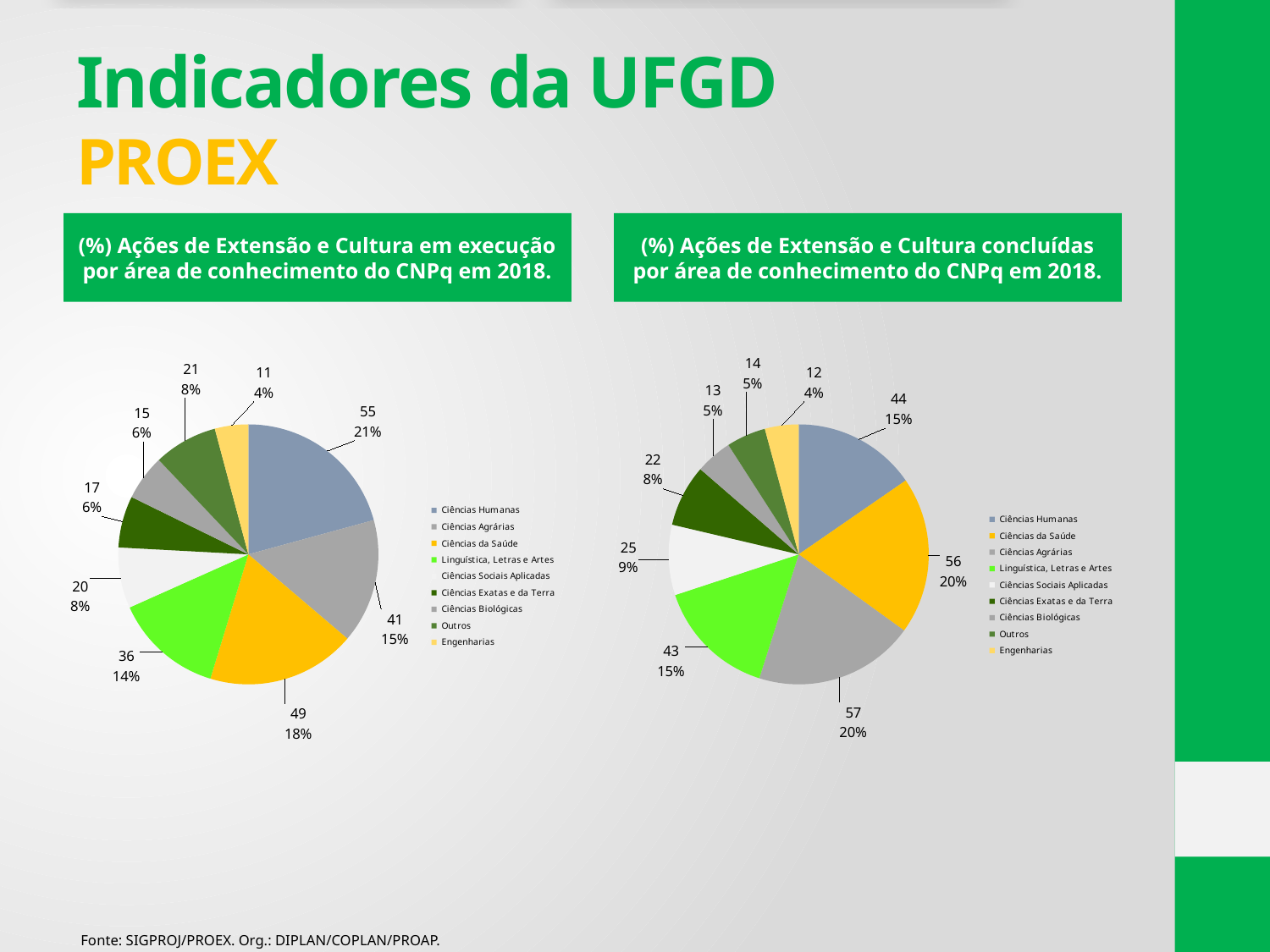
In the left pie chart (ações em execução), which area has the largest slice? Ciências Humanas How many categories does the legend of the left pie chart list? 9 What type of chart is used on the right side of the slide? Pie chart In the left pie chart (ações em execução), which area has the smallest slice? Engenharias In the right pie chart (ações concluídas), which is larger, the value for Ciências Humanas or the value for Ciências Exatas e da Terra? Ciências Humanas In the left pie chart (ações em execução), what value is shown for Ciências Humanas? 55 In the right pie chart (ações concluídas), which area has the smallest slice? Engenharias In the left pie chart (ações em execução), what percentage is shown for Ciências da Saúde? 18% In the right pie chart (ações concluídas), what value is shown for Ciências Agrárias? 57 In the right pie chart (ações concluídas), what percentage is shown for Ciências Sociais Aplicadas? 9% In the right pie chart (ações concluídas), what is the difference between the values for Ciências da Saúde and Linguística, Letras e Artes? 13 In the left pie chart (ações em execução), what is the difference between the values for Ciências Humanas and Ciências Agrárias? 14